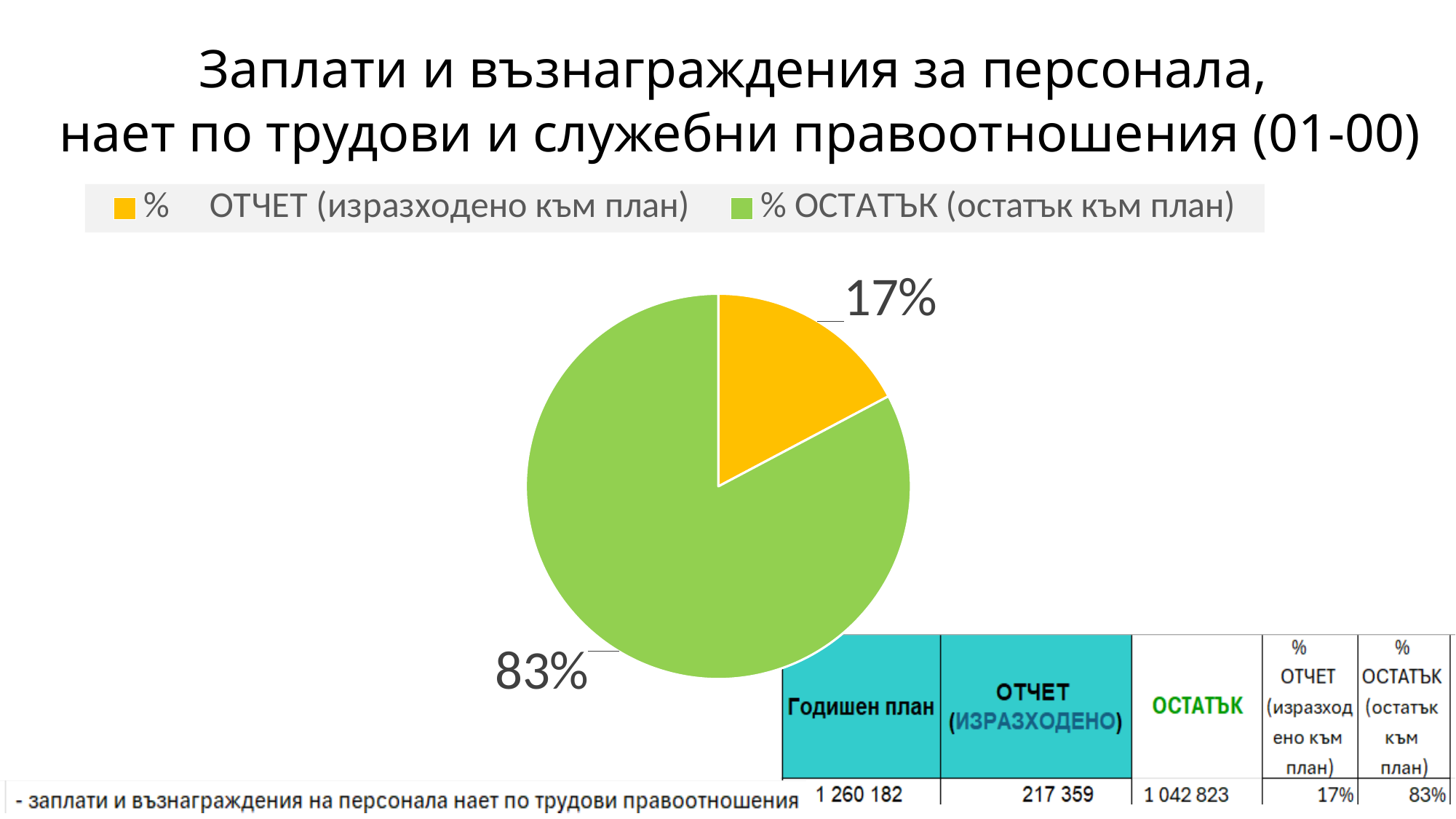
Which slice of the pie is the largest? % ОСТАТЪК (остатък към план) What colour is the "% ОТЧЕТ (изразходено към план)" slice? yellow What colour is the "% ОСТАТЪК (остатък към план)" slice? green What share of the pie does the "% ОСТАТЪК (остатък към план)" slice represent? 83% Which slice of the pie is the smallest? % ОТЧЕТ (изразходено към план) How many entries does the chart legend list? 2 What share of the pie does the "% ОТЧЕТ (изразходено към план)" slice represent? 17% How many slices does the pie chart have? 2 What is the difference in percentage points between the "% ОСТАТЪК" slice and the "% ОТЧЕТ" slice? 66 What kind of chart is shown on the slide? pie chart Which is larger: the "% ОТЧЕТ" slice or the "% ОСТАТЪК" slice? % ОСТАТЪК What is the total of the two pie slice percentages shown? 100%